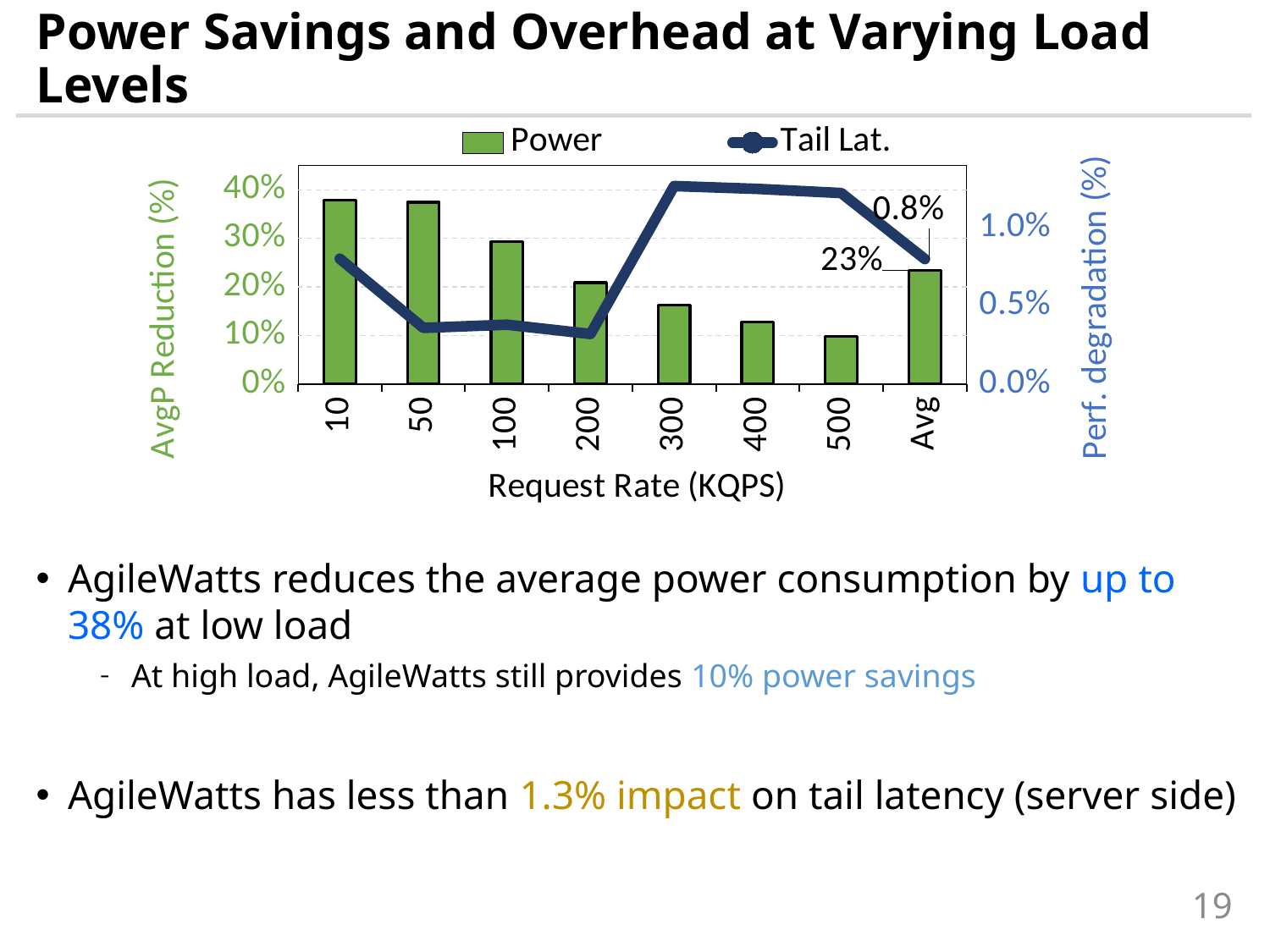
How many categories are shown on the x axis? 8 What is the AvgP Reduction value shown for the Avg category? 23% Is the Tail Lat. value at request rate 50 greater or less than 0.5%? less What is the Tail Lat. (perf. degradation) value labelled for the Avg category? 0.8% How many series does the legend list? 2 Is the Power bar for request rate 500 greater or less than 20%? less Which request rate has the lowest Power (AvgP Reduction) bar? 500 Is the Power bar for request rate 10 greater or less than 30%? greater Do the Power bars rise or fall as the request rate increases from 10 to 500? fall Which has a higher Tail Lat. value, request rate 50 or request rate 300? 300 Which has a larger Power (AvgP Reduction) bar, request rate 100 or request rate 400? 100